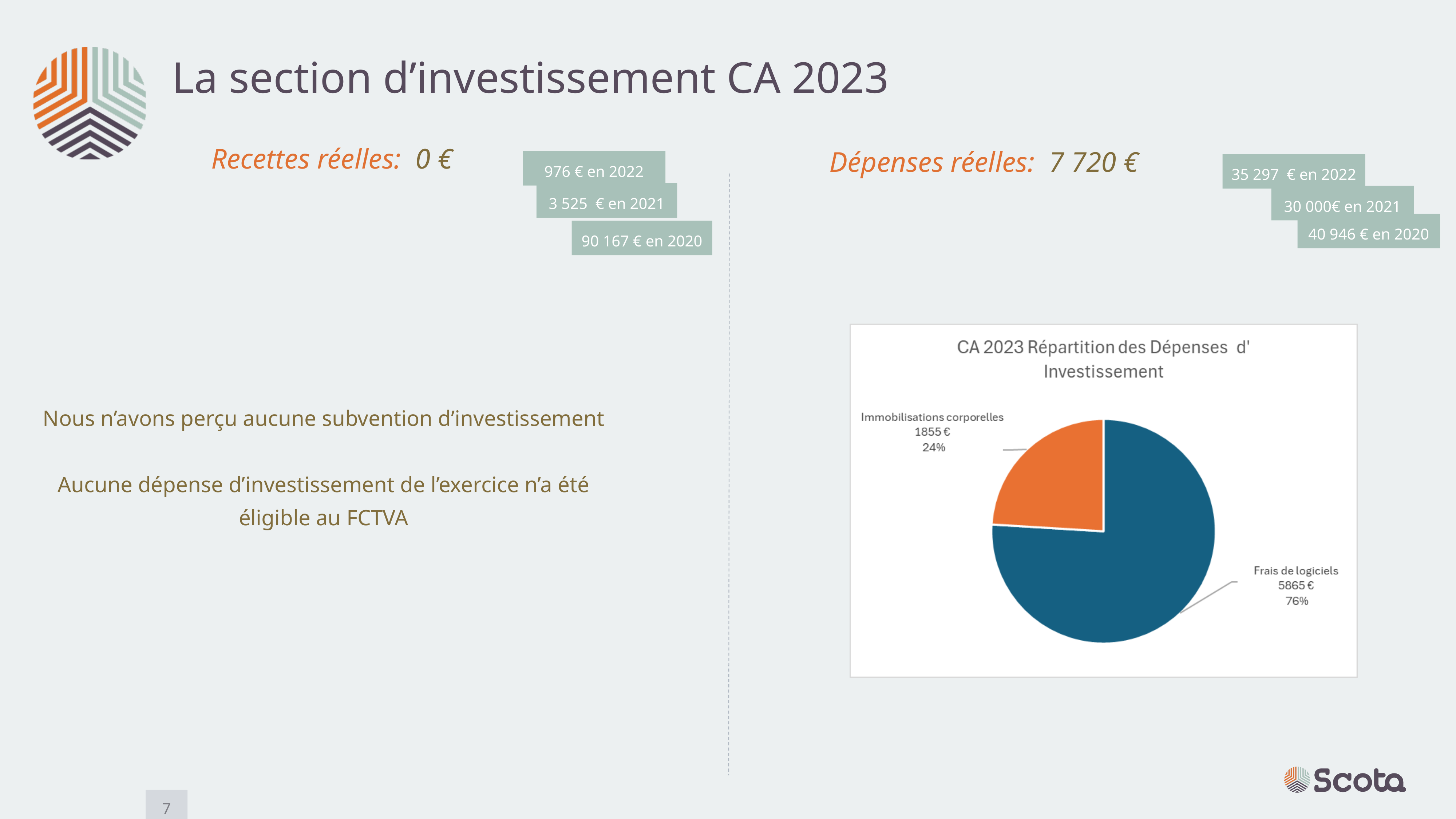
What kind of chart is shown on the slide? Pie chart What colour is the Frais de logiciels slice? Blue How many slices does the pie chart have? 2 What is the difference in euros between Frais de logiciels and Immobilisations corporelles? 4010 € Which category has the largest slice of the pie? Frais de logiciels Which category has the smallest slice of the pie? Immobilisations corporelles What share of the pie does Immobilisations corporelles represent? 24% What is the value shown for Immobilisations corporelles? 1855 € What is the title of the chart? CA 2023 Répartition des Dépenses d' Investissement Which is larger, Immobilisations corporelles or Frais de logiciels? Frais de logiciels What share of the pie does Frais de logiciels represent? 76% What is the value shown for Frais de logiciels? 5865 €